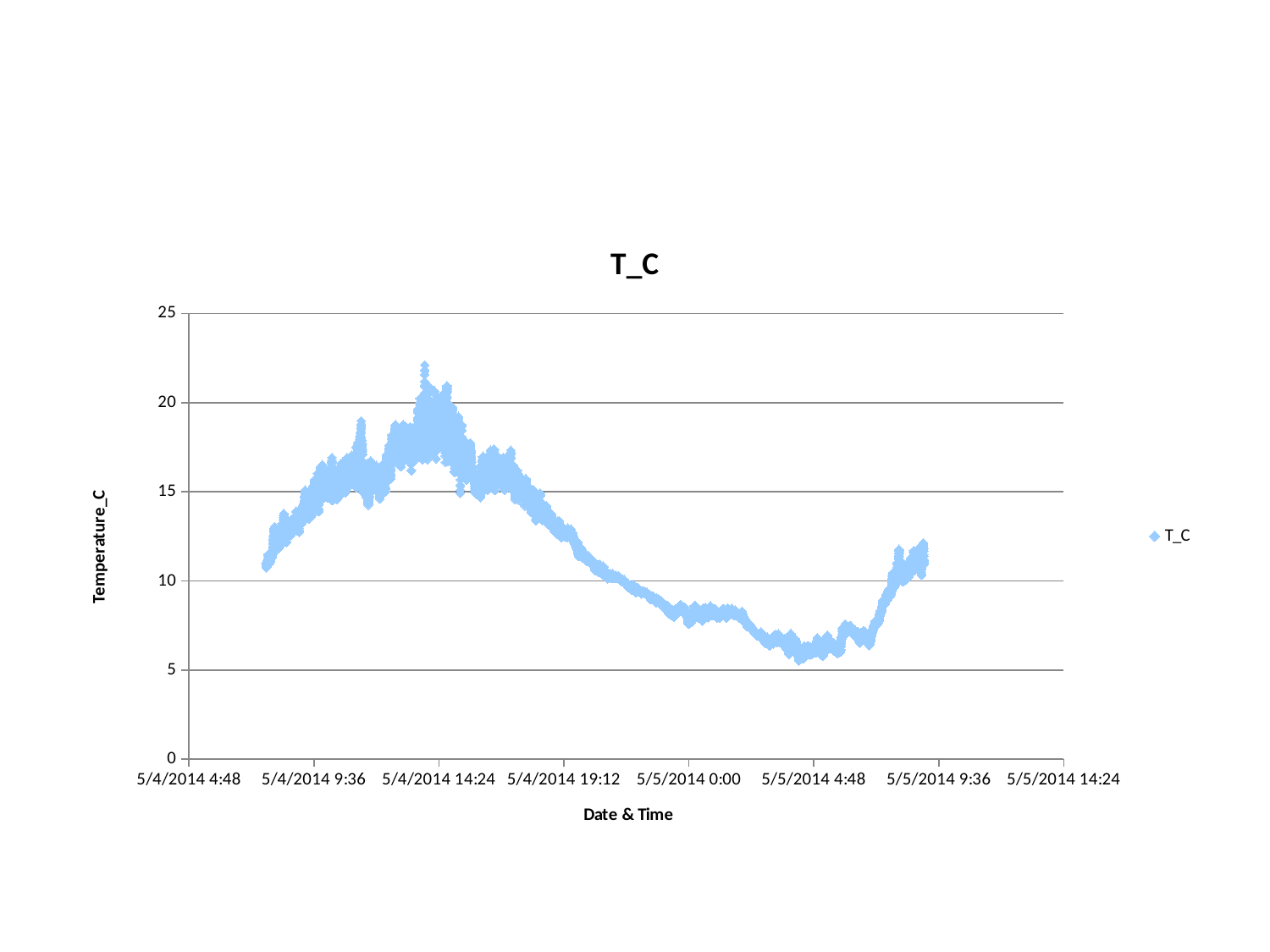
Around which x-axis tick does the temperature reach its highest value? 5/4/2014 14:24 Between 5/4/2014 14:24 and 5/5/2014 4:48, does the temperature rise or fall? fall Is the temperature value at 5/4/2014 9:36 greater or less than 10? greater Around which x-axis tick does the temperature reach its lowest value? 5/5/2014 4:48 Is the lowest temperature value plotted greater or less than 10? less What is the label on the vertical axis? Temperature_C Is the temperature value at 5/5/2014 0:00 greater or less than 10? less How many series does the legend list? 1 What kind of chart is shown on the slide? scatter chart What is the title of the chart? T_C